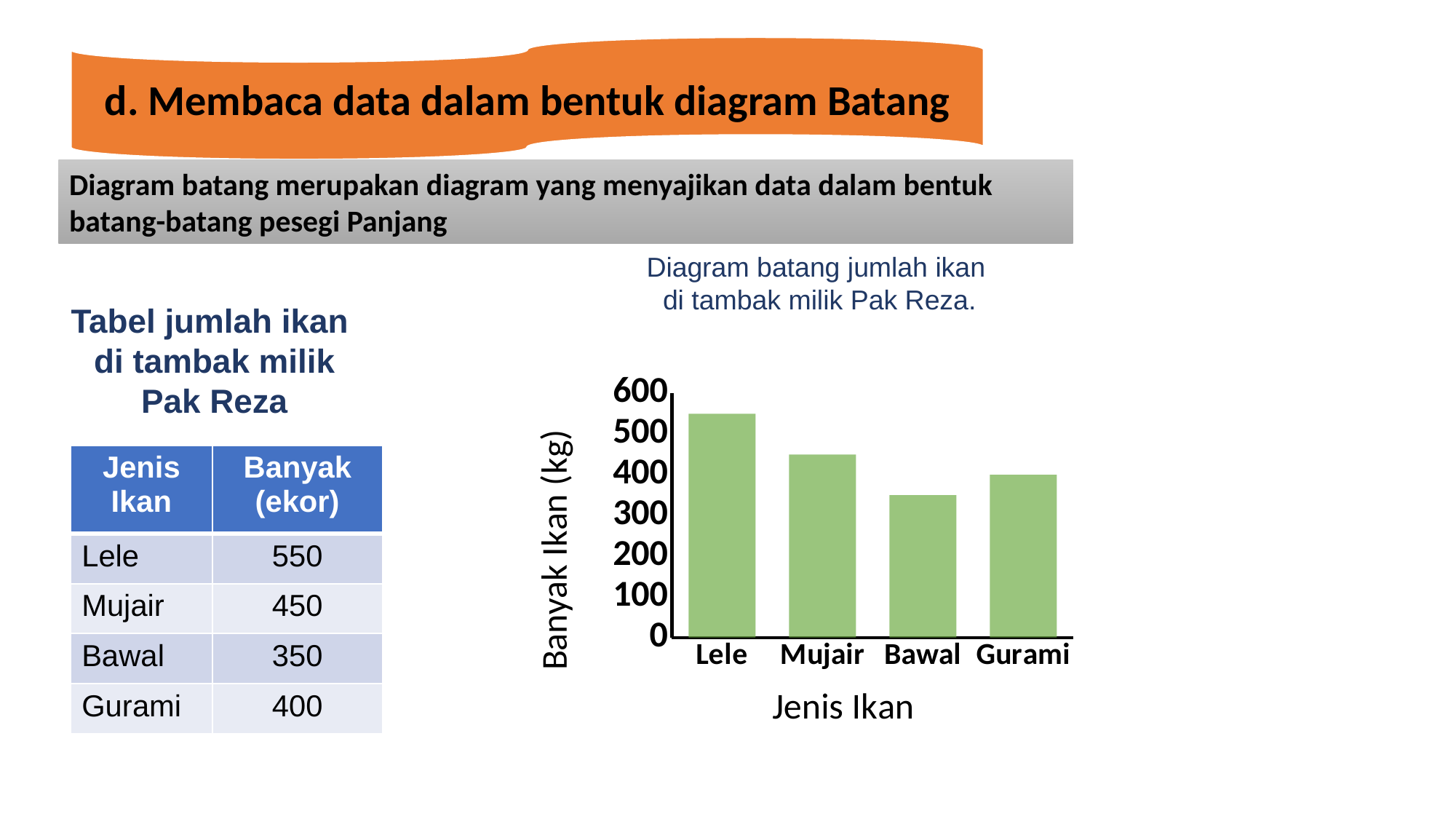
Which is larger in the chart, the bar for Mujair or the bar for Gurami? Mujair Is the bar for Mujair greater or less than 400? greater What kind of chart is shown on the slide? bar chart What is the label of the y axis of the bar chart? Banyak Ikan (kg) How many categories (fish types) are shown on the x axis of the bar chart? 4 Which fish type has the lowest bar in the chart? Bawal Which fish type has the highest bar in the chart? Lele What is the label of the x axis of the bar chart? Jenis Ikan Is the bar for Bawal greater or less than 400? less According to the slide, what is the difference between the values for Lele and Bawal? 200 According to the slide, what is the value for Gurami? 400 Is the bar for Lele greater or less than 500? greater